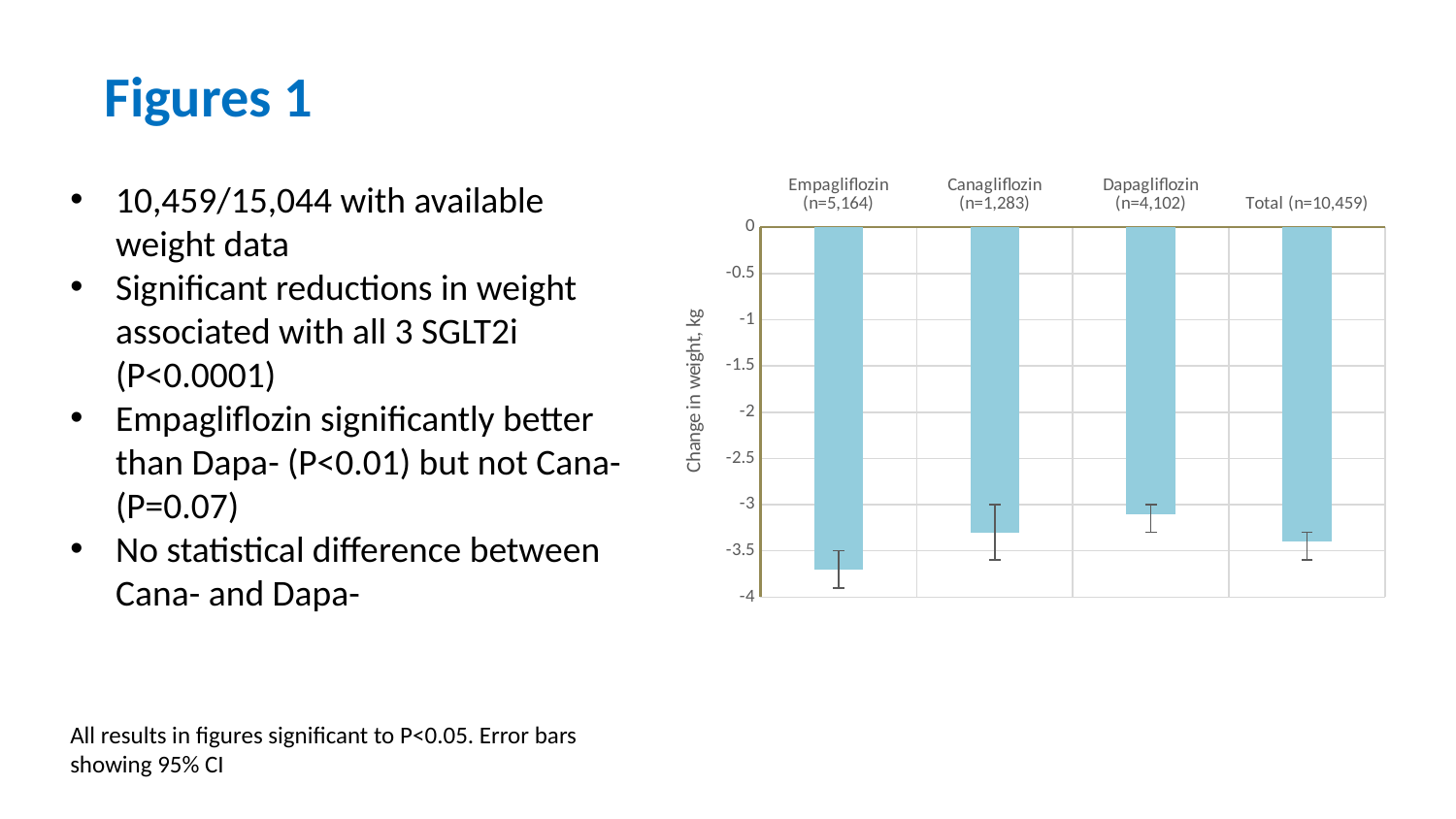
What is the label of the vertical axis of the chart? Change in weight, kg Which category shows the lowest value (largest weight reduction) in the chart? Empagliflozin Is the value for Canagliflozin greater or less than -3? less What sample size is shown for Canagliflozin in the chart's category label? n=1,283 Is the value for Dapagliflozin greater or less than -3.5? greater Which has the larger weight reduction (more negative value), Canagliflozin or Dapagliflozin? Canagliflozin How many categories (bars) are plotted in the chart? 4 Which category shows the highest value (smallest weight reduction) in the chart? Dapagliflozin Is the value for Empagliflozin greater or less than -3.5? less What kind of chart is shown on the slide? bar chart Which has the larger weight reduction (more negative value), Empagliflozin or Dapagliflozin? Empagliflozin